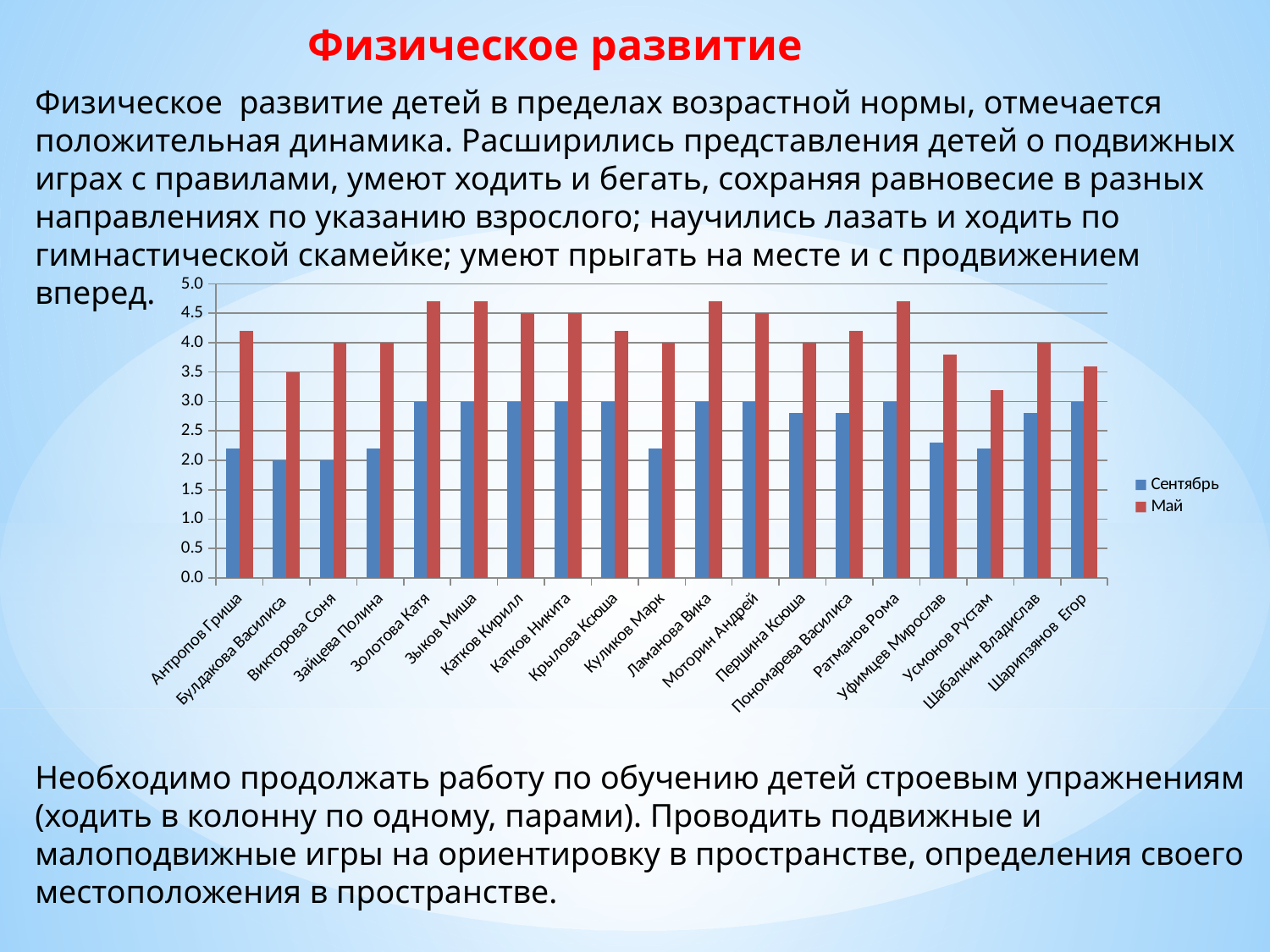
What is the Сентябрь value for Викторова Соня? 2.0 What is the difference between the Май and Сентябрь values for Викторова Соня? 2.0 Which series is larger for Куликов Марк, Сентябрь or Май? Май How many children (categories) are shown on the x axis of the chart? 19 Is the Сентябрь value for Уфимцев Мирослав greater or less than 2.5? less What is the Май value for Катков Кирилл? 4.5 What is the Май value for Булдакова Василиса? 3.5 Is the Май value for Золотова Катя greater or less than 4.5? greater What is the Сентябрь value for Шарипзянов Егор? 3.0 How many series does the chart legend list? 2 Which child has the lowest Май value? Усмонов Рустам What kind of chart is shown on the slide? bar chart